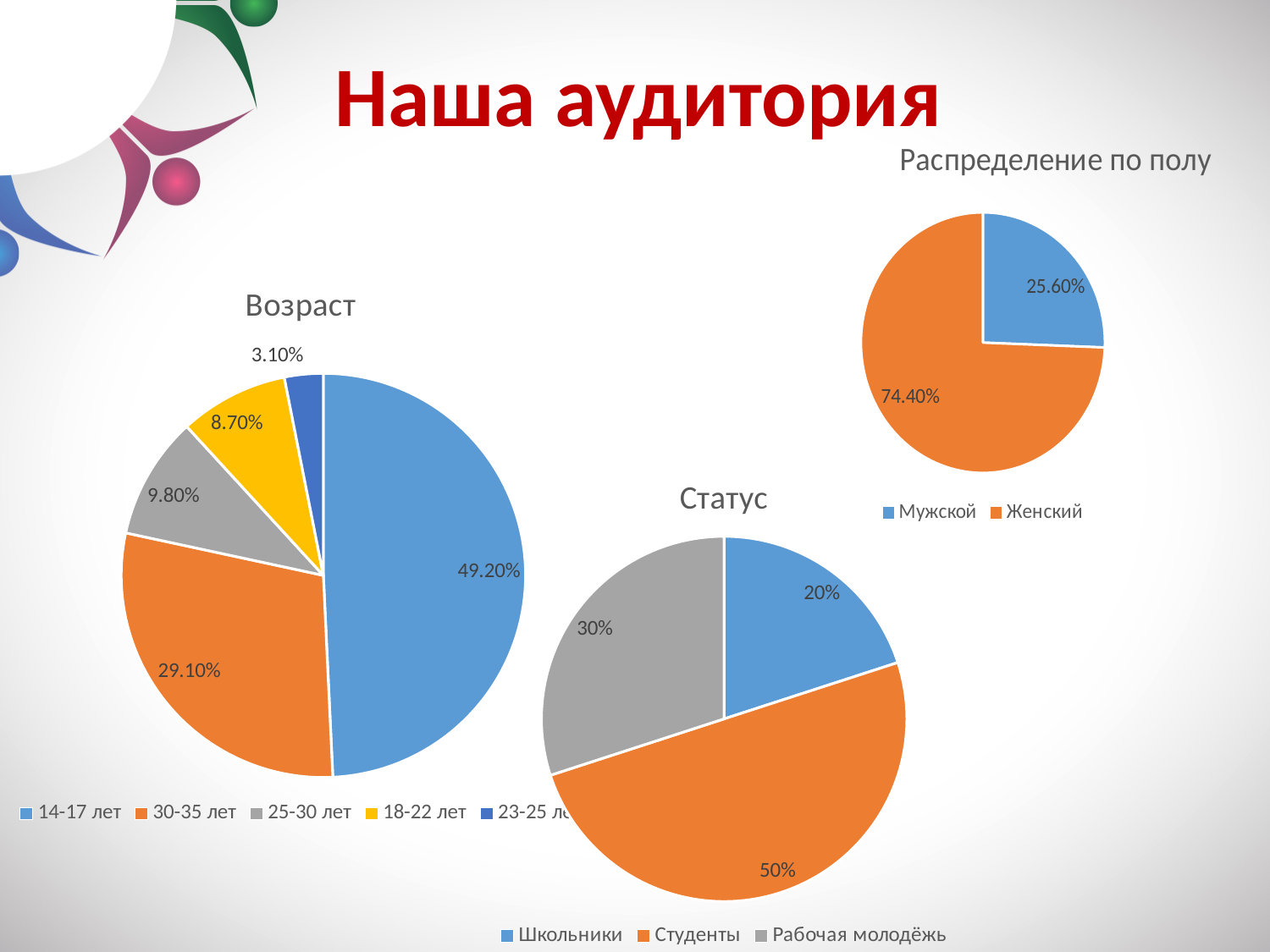
In the "Статус" chart, which is larger, Рабочая молодёжь or Школьники? Рабочая молодёжь In the "Возраст" chart, what share is shown for 30-35 лет? 29.10% In the "Распределение по полу" chart, what share is shown for Женский? 74.40% In the "Возраст" chart, what share is shown for 14-17 лет? 49.20% In the "Статус" chart, how many categories does the legend list? 3 What type of chart is the "Распределение по полу" chart? Pie chart In the "Распределение по полу" chart, what is the difference between the Женский and Мужской shares? 48.80% In the "Возраст" chart, which age group has the largest slice? 14-17 лет In the "Статус" chart, what share is shown for Студенты? 50% In the "Статус" chart, which category has the smallest slice? Школьники What is the title of the chart in the top right of the slide? Распределение по полу In the "Возраст" chart, what is the difference between the shares for 25-30 лет and 18-22 лет? 1.10%